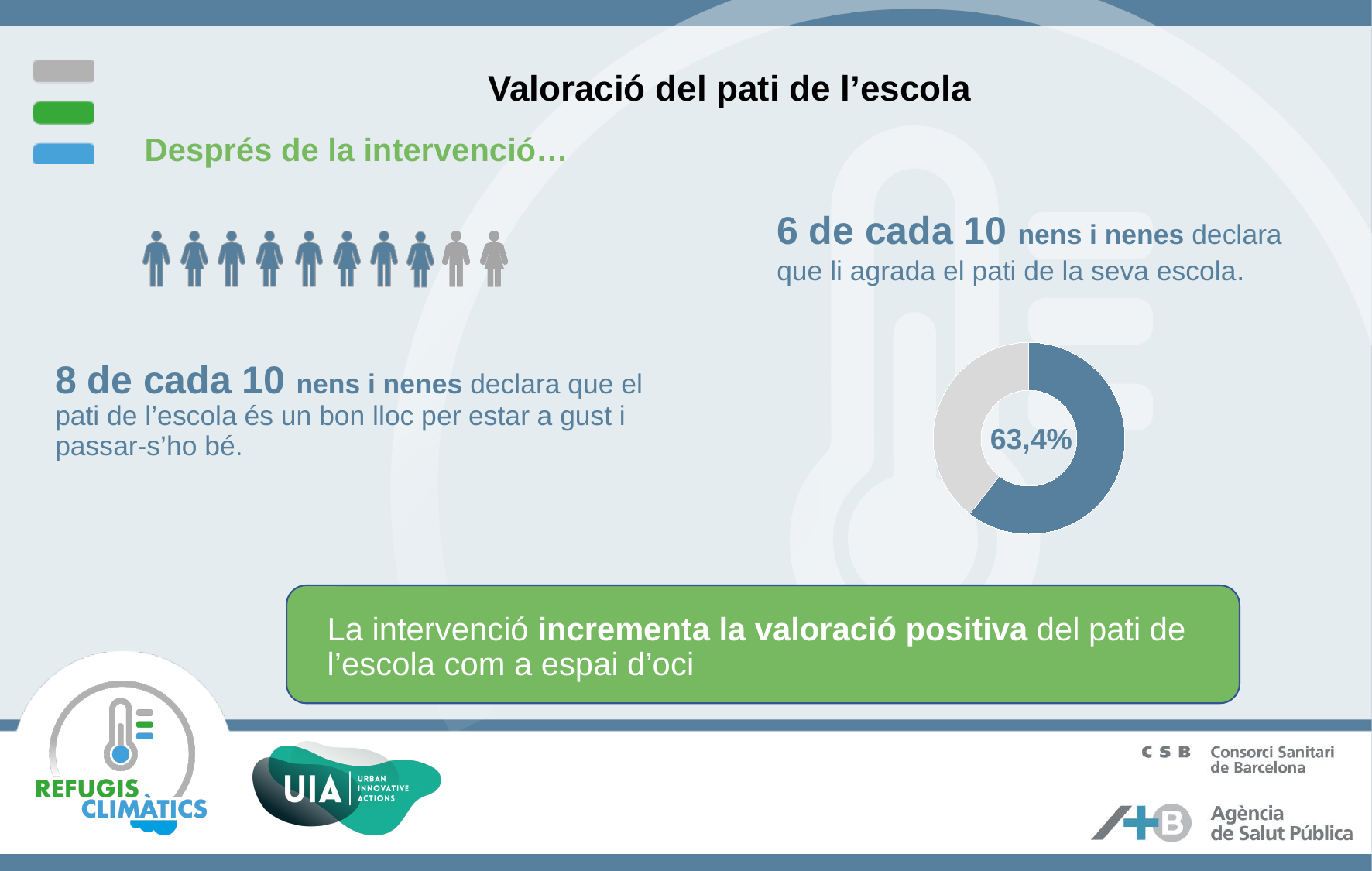
How many of the person icons in the pictogram are coloured grey? 2 How many of the person icons in the pictogram are coloured blue? 8 How many slices does the donut chart have? 2 According to the pictogram, how many out of every 10 children say the school playground is a good place to feel comfortable and have fun? 8 de cada 10 What is the title of the slide containing the donut chart? Valoració del pati de l'escola What colour is the slice labelled 63,4% in the donut chart? Blue In the donut chart, which slice is larger, the blue one or the grey one? The blue one What share of the donut chart does the grey slice represent, given the blue slice is 63,4%? 36,6% What kind of chart is shown on the right side of the slide? Donut (pie) chart Is the blue slice of the donut chart greater or less than 50%? greater What value is printed on the donut chart on the right of the slide? 63,4%